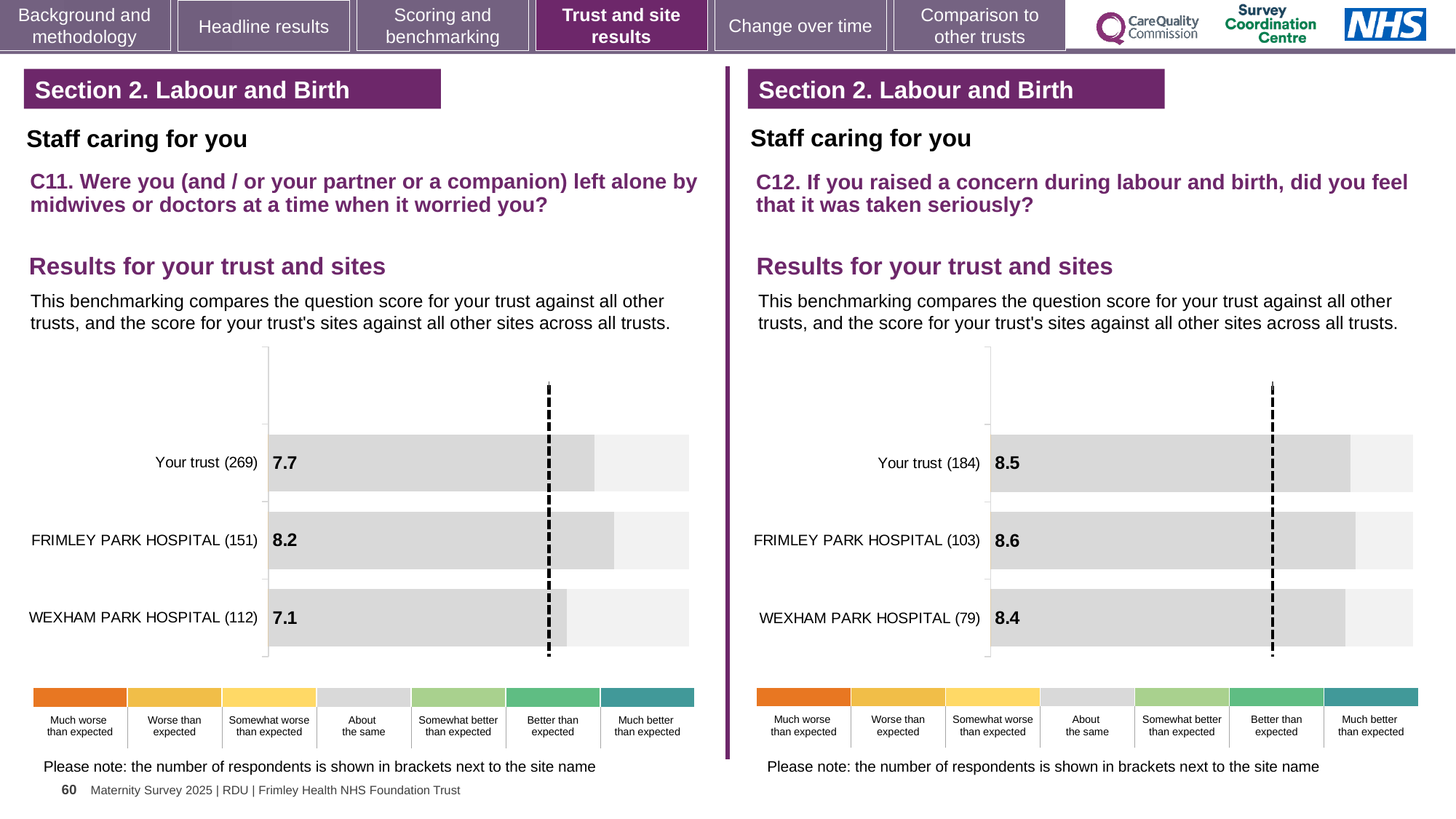
In the C12 chart on the right, what is the score for Your trust? 8.5 In the C11 chart on the left, which site or trust has the lowest score? WEXHAM PARK HOSPITAL In the C12 chart on the right, how many categories does the colour key below the chart list? 7 In the C12 chart on the right, how many respondents are shown in brackets for WEXHAM PARK HOSPITAL? 79 In the C12 chart on the right, what is the difference between the scores for FRIMLEY PARK HOSPITAL and Your trust? 0.1 In the C11 chart on the left, what is the difference between the scores for FRIMLEY PARK HOSPITAL and WEXHAM PARK HOSPITAL? 1.1 In the C11 chart on the left, what is the score for FRIMLEY PARK HOSPITAL? 8.2 What kind of chart is the C11 chart on the left? Bar chart In the C11 chart on the left, how many bars are plotted? 3 In the C12 chart on the right, what is the score for WEXHAM PARK HOSPITAL? 8.4 In the C11 chart on the left, which site or trust has the highest score? FRIMLEY PARK HOSPITAL In the C11 chart on the left, what is the score for WEXHAM PARK HOSPITAL? 7.1